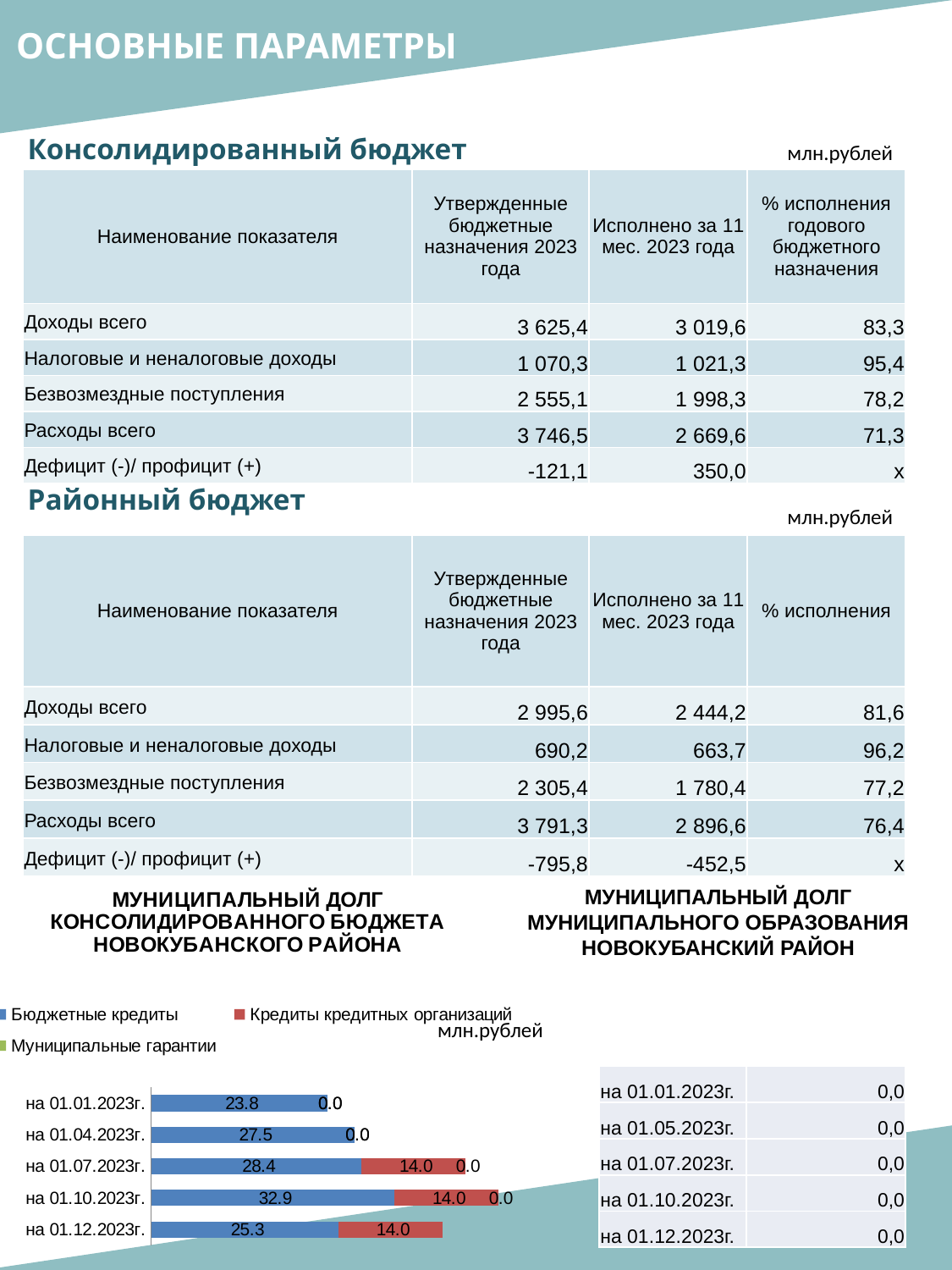
What kind of chart is shown under the heading 'МУНИЦИПАЛЬНЫЙ ДОЛГ КОНСОЛИДИРОВАННОГО БЮДЖЕТА НОВОКУБАНСКОГО РАЙОНА'? bar chart In the municipal debt chart, what is the total of the stacked bar на 01.10.2023г.? 46.9 In the municipal debt chart, how many dates are shown on the vertical axis? 5 In the municipal debt chart, which series is shown in red? Кредиты кредитных организаций In the municipal debt chart, what is the difference between 'Бюджетные кредиты' на 01.10.2023г. and на 01.12.2023г.? 7.6 In the municipal debt chart, what is the value of 'Бюджетные кредиты' на 01.10.2023г.? 32.9 In the municipal debt chart, which is larger: 'Бюджетные кредиты' на 01.04.2023г. or на 01.07.2023г.? на 01.07.2023г. In the municipal debt chart, on which date is 'Бюджетные кредиты' highest? на 01.10.2023г. In the municipal debt chart, on which date is 'Бюджетные кредиты' lowest? на 01.01.2023г. In the municipal debt chart, what is the value of 'Бюджетные кредиты' на 01.01.2023г.? 23.8 How many series does the legend of the municipal debt chart list? 3 In the municipal debt chart, what is the value of 'Кредиты кредитных организаций' на 01.07.2023г.? 14.0